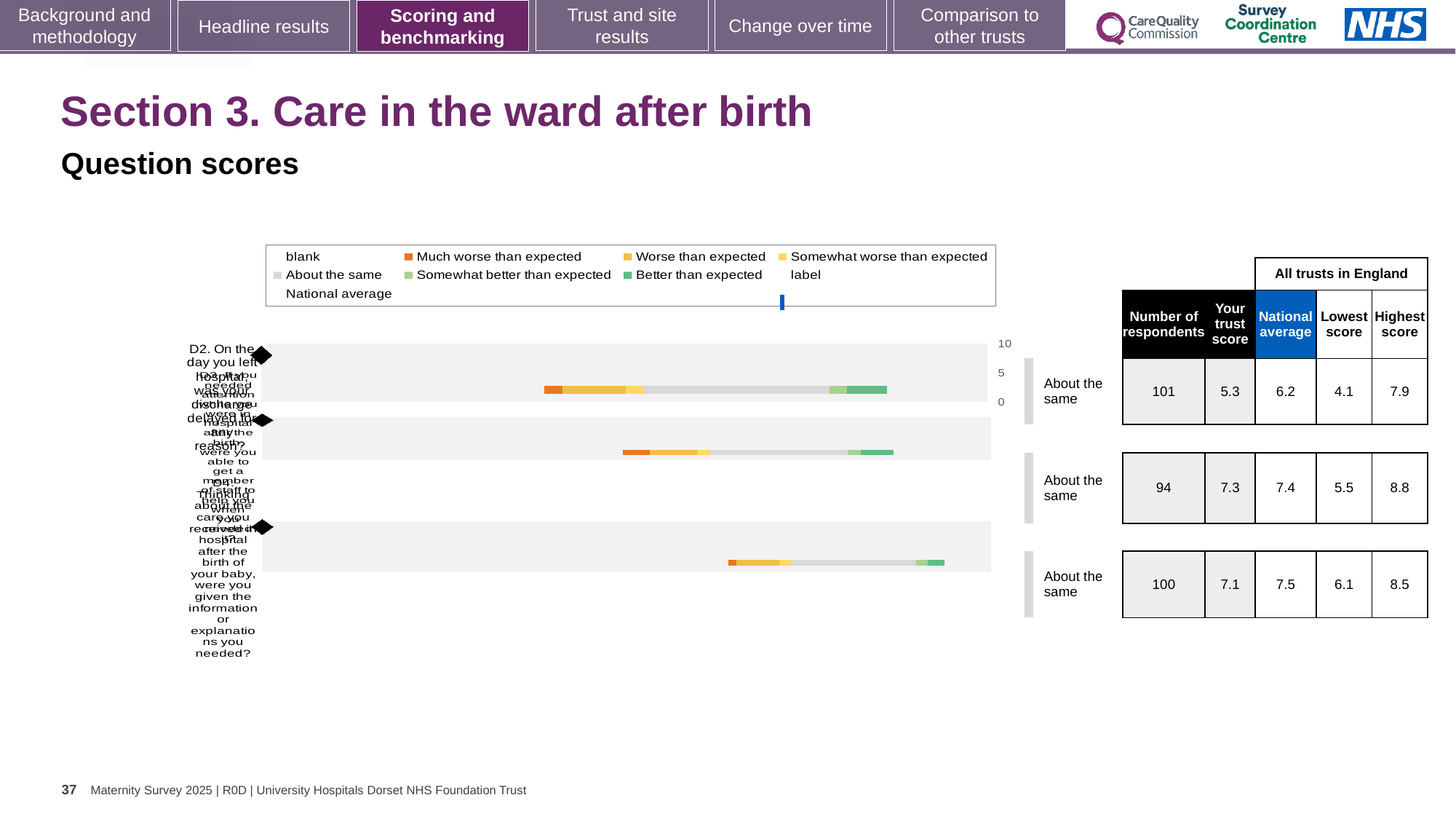
What kind of chart is shown on the slide? bar chart In the table beside the chart, what is the 'Highest score' for the second question row? 8.8 In the table beside the chart, what is the 'Your trust score' for the first (top) question row? 5.3 In the table beside the chart, what is the 'National average' for the second question row? 7.4 What colour does the legend use for 'Much worse than expected'? orange In the table beside the chart, which question row has the lowest 'Your trust score'? the first (top) row How many question rows (bars) are plotted in the chart? 3 What is the highest tick value shown on the chart's score axis? 10 In the table beside the chart, what is the difference between the 'National average' and 'Your trust score' for the first (top) question row? 0.9 What colour does the legend use for 'About the same'? grey In the table beside the chart, is the 'Your trust score' for the second row larger or smaller than for the third row? larger In the table beside the chart, what is the 'Number of respondents' for the third (bottom) question row? 100